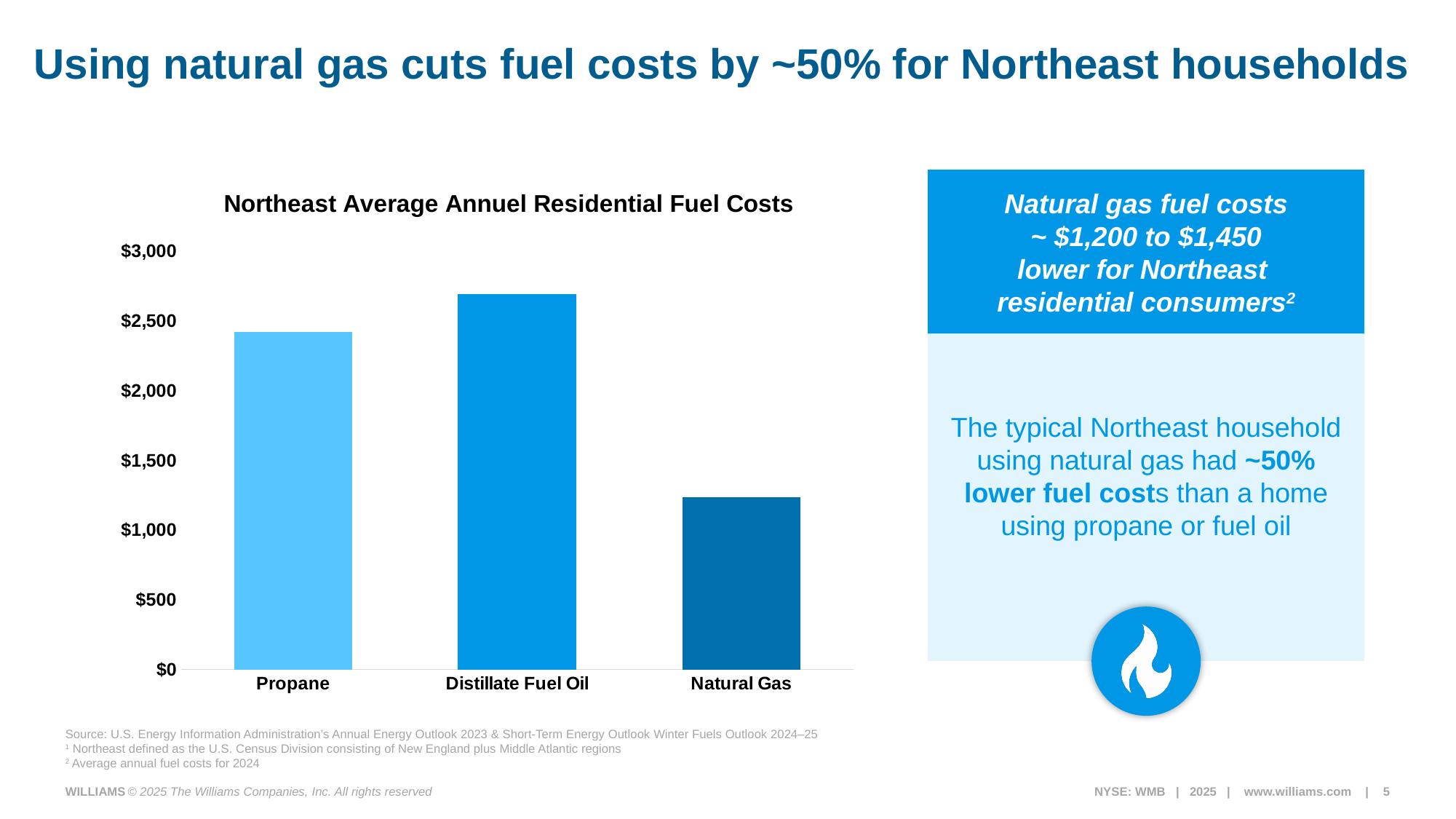
What kind of chart is shown on the slide? bar chart Which has the larger value in the chart, Propane or Natural Gas? Propane Which has the larger value in the chart, Propane or Distillate Fuel Oil? Distillate Fuel Oil Is the value for Distillate Fuel Oil greater or less than $2,500? greater How many fuel categories are shown in the chart? 3 Is the value for Natural Gas greater or less than $1,500? less Is the value for Natural Gas greater or less than $1,000? greater Does the value rise or fall from Distillate Fuel Oil to Natural Gas along the x axis? fall Which fuel has the highest average annual residential fuel cost in the chart? Distillate Fuel Oil Which fuel has the lowest average annual residential fuel cost in the chart? Natural Gas What is the title of the chart? Northeast Average Annuel Residential Fuel Costs